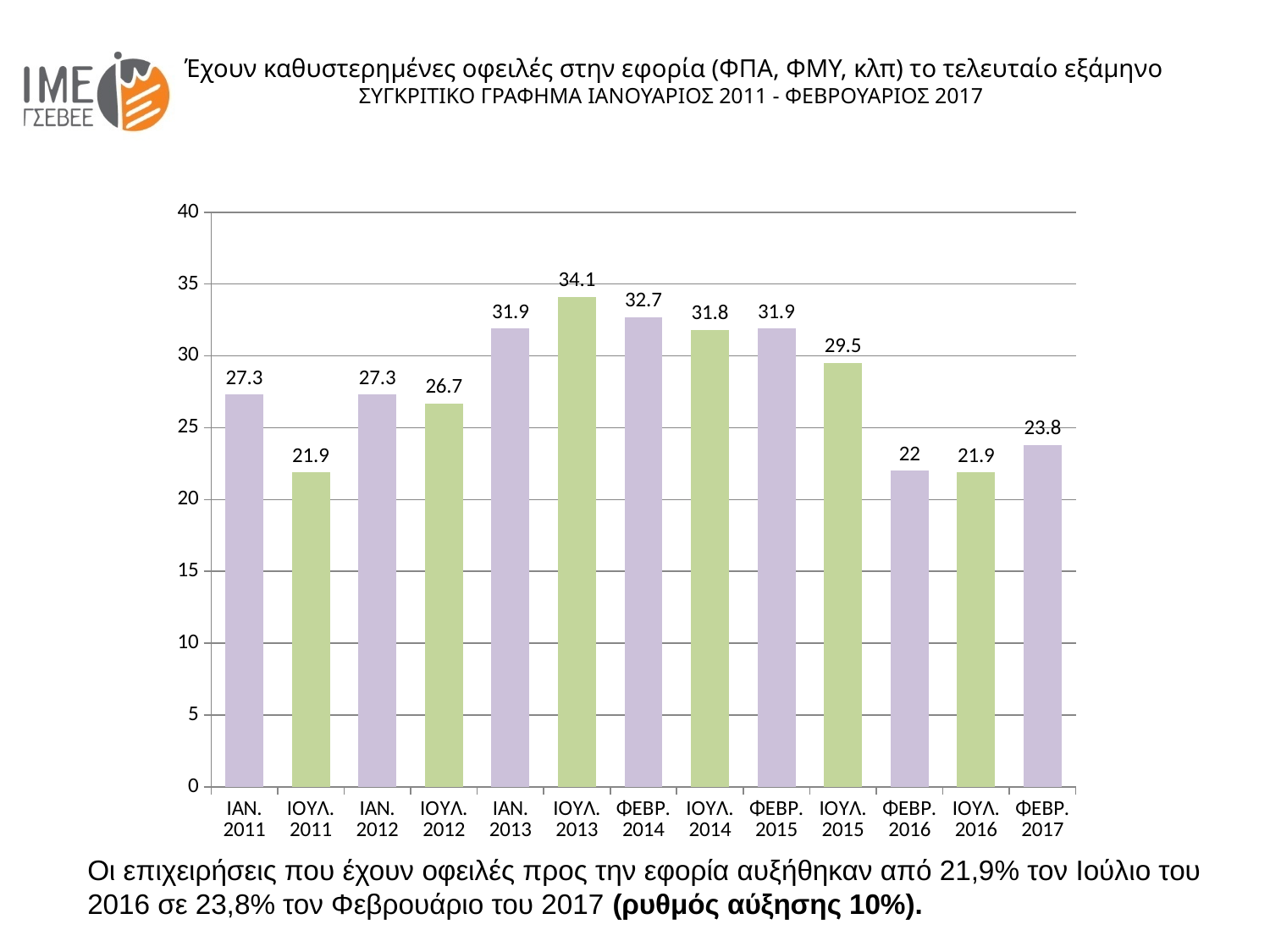
Is the value for ΙΑΝ. 2013 greater or less than 30? greater How many periods are shown on the x axis? 13 Which period has the highest value? ΙΟΥΛ. 2013 What is the value for ΦΕΒΡ. 2016? 22 What is the difference between the values for ΙΟΥΛ. 2013 and ΦΕΒΡ. 2014? 1.4 Do the values rise or fall from ΙΟΥΛ. 2013 to ΦΕΒΡ. 2016? fall Which is larger, the value for ΙΟΥΛ. 2015 or the value for ΦΕΒΡ. 2015? ΦΕΒΡ. 2015 What is the value for ΦΕΒΡ. 2017? 23.8 What kind of chart is shown on the slide? bar chart What is the value for ΙΟΥΛ. 2013? 34.1 What is the difference between the values for ΦΕΒΡ. 2017 and ΙΟΥΛ. 2016? 1.9 What is the lowest value shown in the chart? 21.9